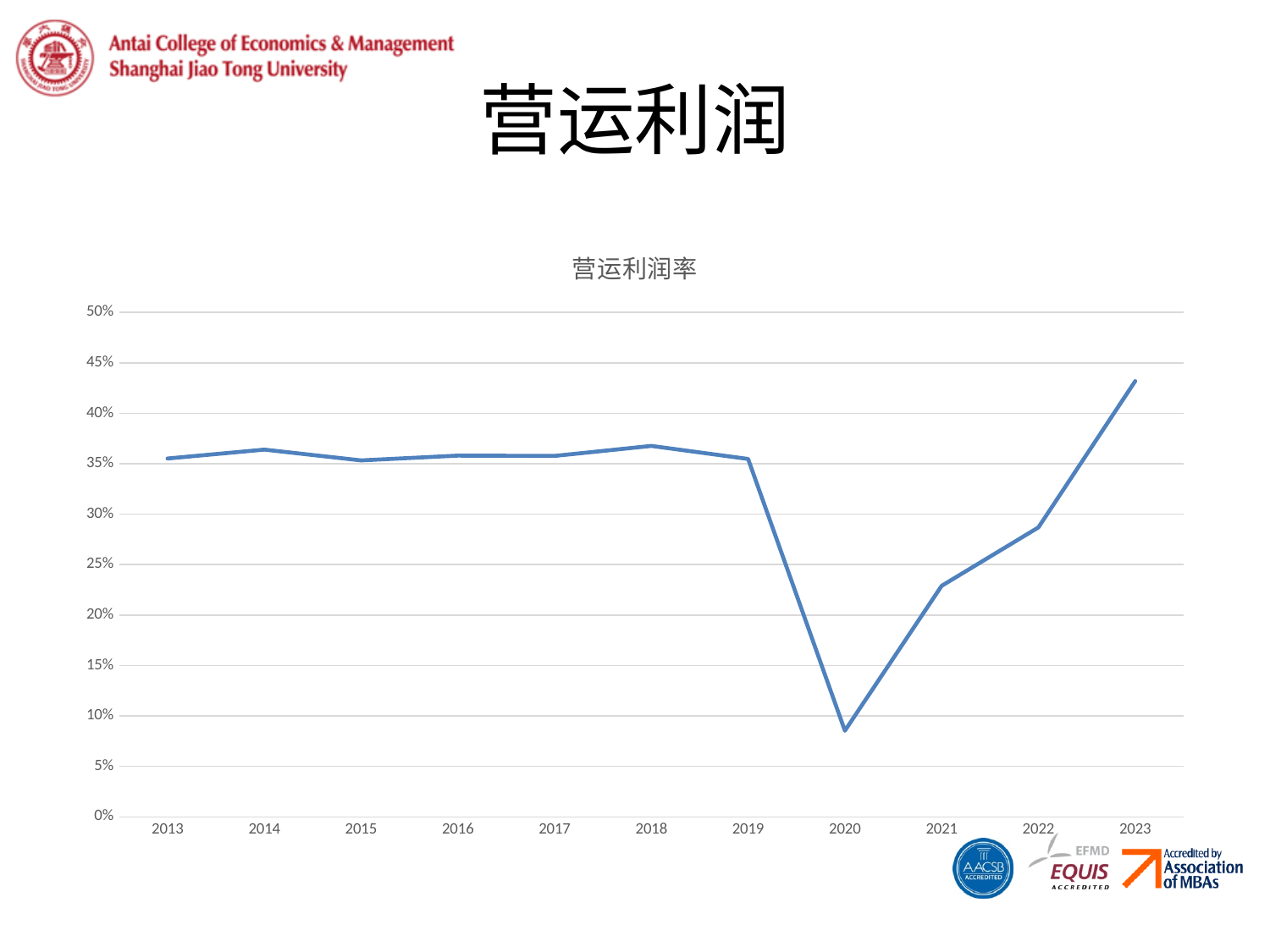
What kind of chart is shown on the slide? line chart Is the value for 2018 greater or less than 35%? greater Which year has the larger value, 2020 or 2021? 2021 How many years are plotted on the x axis of the chart? 11 Is the value for 2020 greater or less than 10%? less Which year has the lowest operating profit margin in the chart? 2020 Do the values rise or fall from 2020 to 2023? rise What is the title of the chart? 营运利润率 Is the value for 2023 greater or less than 40%? greater Which year has the larger value, 2022 or 2023? 2023 Which year has the highest operating profit margin in the chart? 2023